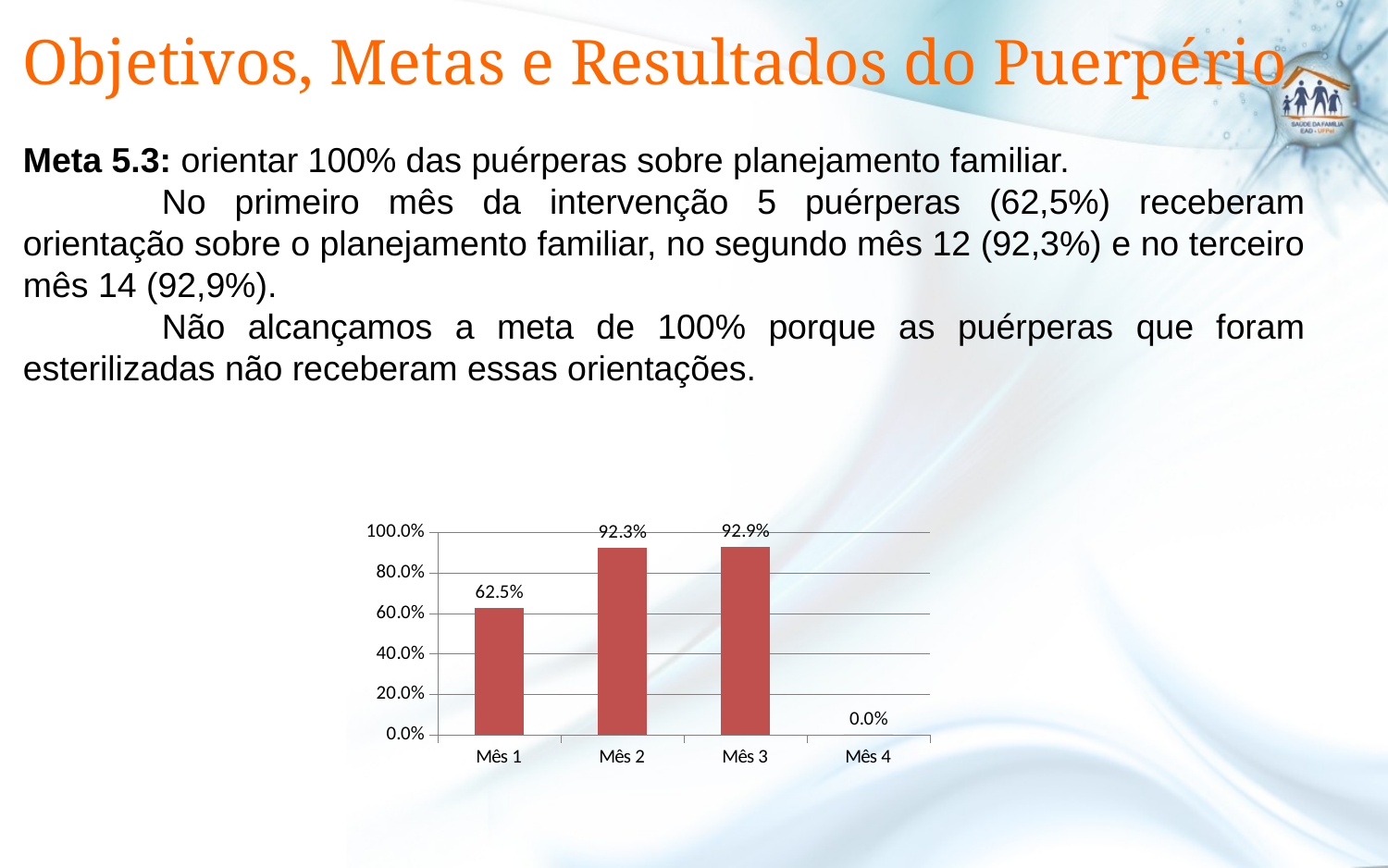
What is the highest value shown on the y axis? 100.0% What is the difference between the values for Mês 3 and Mês 2? 0.6% What is the value for Mês 2? 92.3% What is the value for Mês 4? 0.0% How many categories are shown on the x axis? 4 Which is larger, the value for Mês 1 or the value for Mês 2? Mês 2 What is the value for Mês 1? 62.5% Which category has the lowest value? Mês 4 Is the value for Mês 1 greater or less than 80.0%? less What is the value for Mês 3? 92.9% What is the difference between the values for Mês 2 and Mês 1? 29.8% What kind of chart is shown on the slide? bar chart